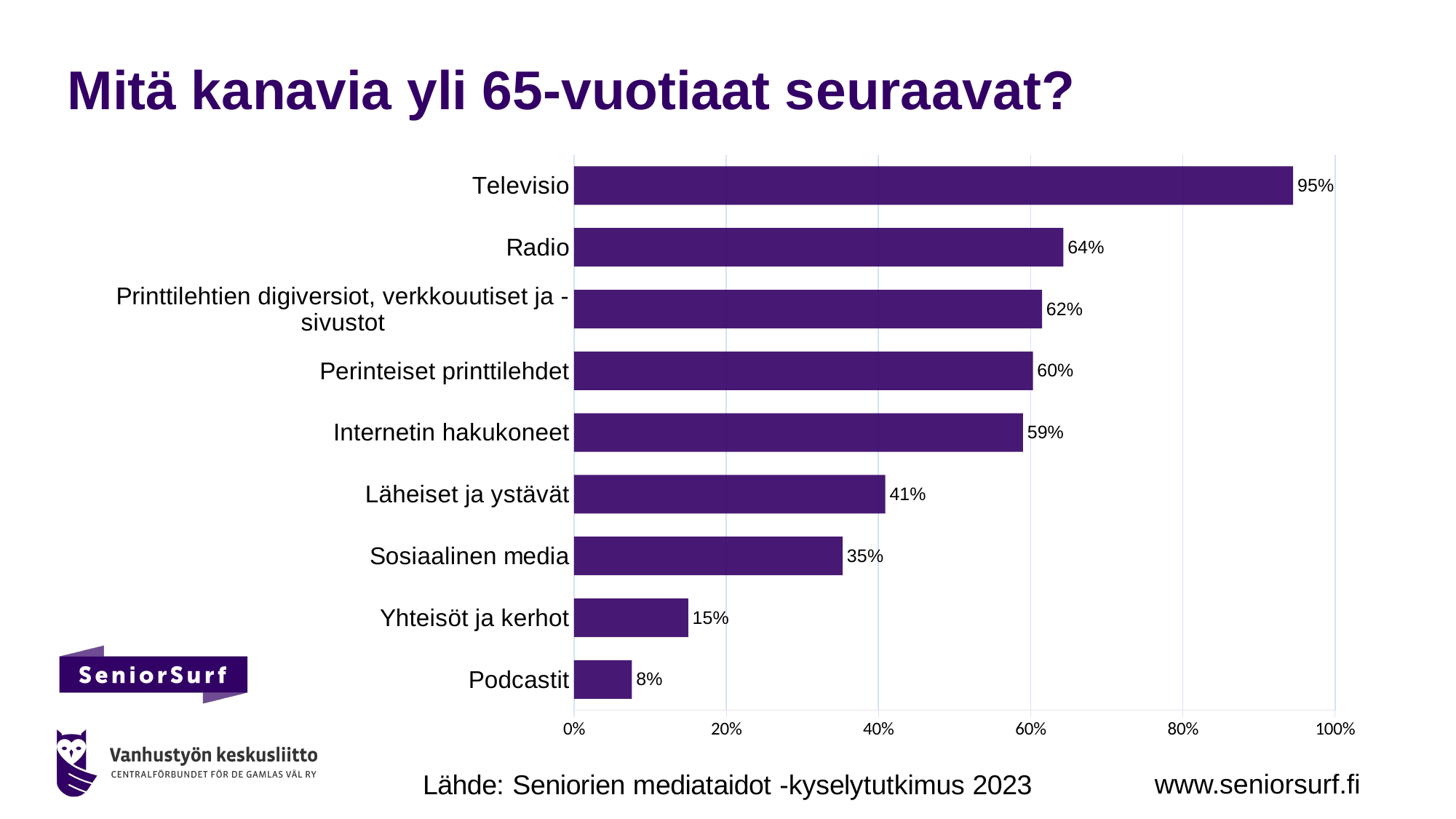
What is the value for Sosiaalinen media? 35% What is the title of the slide? Mitä kanavia yli 65-vuotiaat seuraavat? Which category has the highest value? Televisio What is the value for Internetin hakukoneet? 59% What kind of chart is shown on the slide? Bar chart Is the value for Läheiset ja ystävät greater or less than 40%? greater Which category has the lowest value? Podcastit How many categories are shown in the chart? 9 Which is larger, the value for Radio or the value for Perinteiset printtilehdet? Radio What is the difference between the values for Läheiset ja ystävät and Yhteisöt ja kerhot? 26% What is the difference between the values for Radio and Podcastit? 56% What is the value for Televisio? 95%